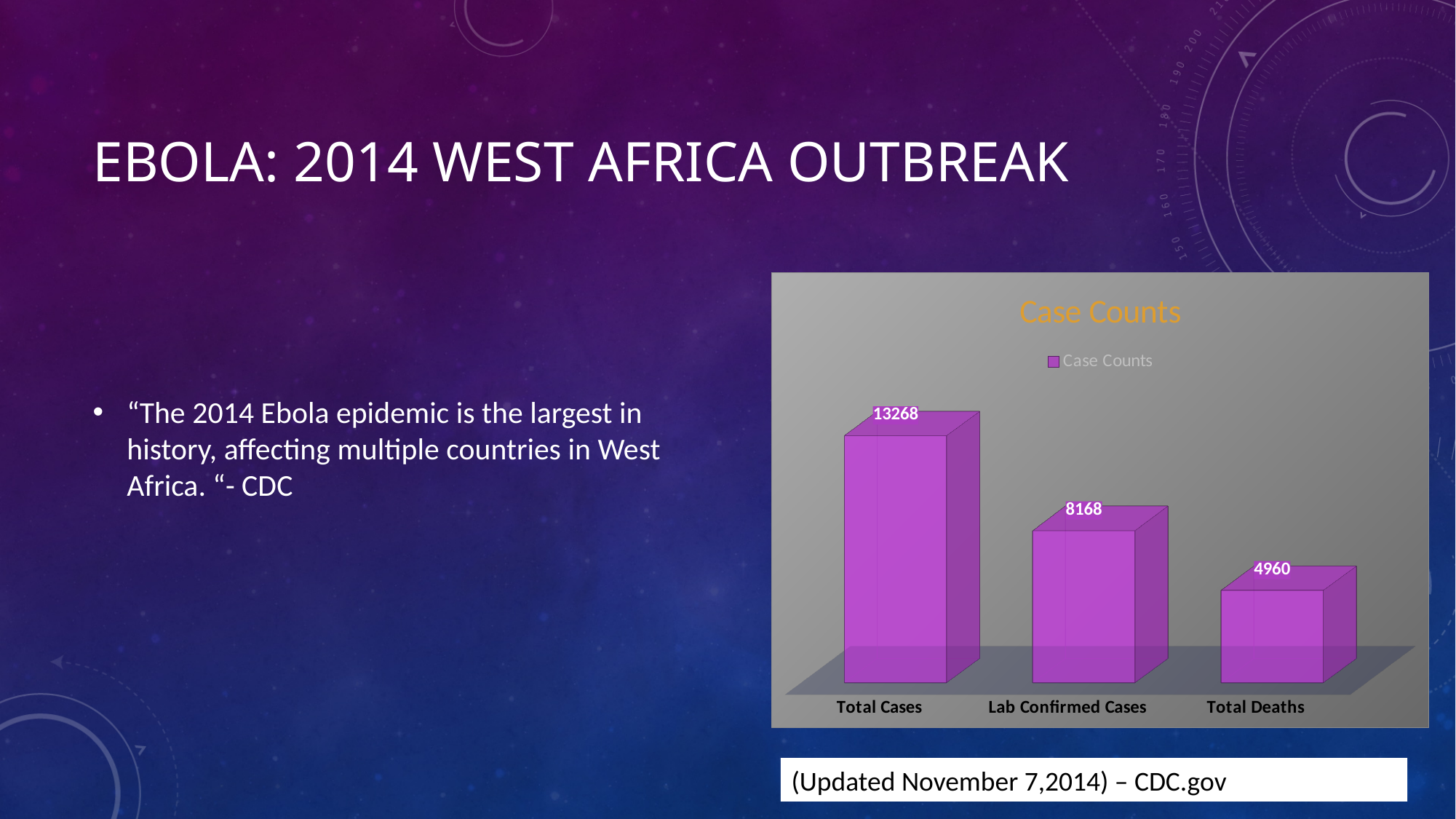
Which category has the lowest value? Total Deaths What is the difference between Total Cases and Lab Confirmed Cases? 5100 How many series does the legend list? 1 Which is larger, Lab Confirmed Cases or Total Deaths? Lab Confirmed Cases What is the difference between Lab Confirmed Cases and Total Deaths? 3208 What is the value for Lab Confirmed Cases? 8168 What kind of chart is shown on the slide? Bar chart What is the value for Total Deaths? 4960 How many categories are shown in the chart? 3 What is the title of the chart? Case Counts What is the value for Total Cases? 13268 Which category has the highest value? Total Cases